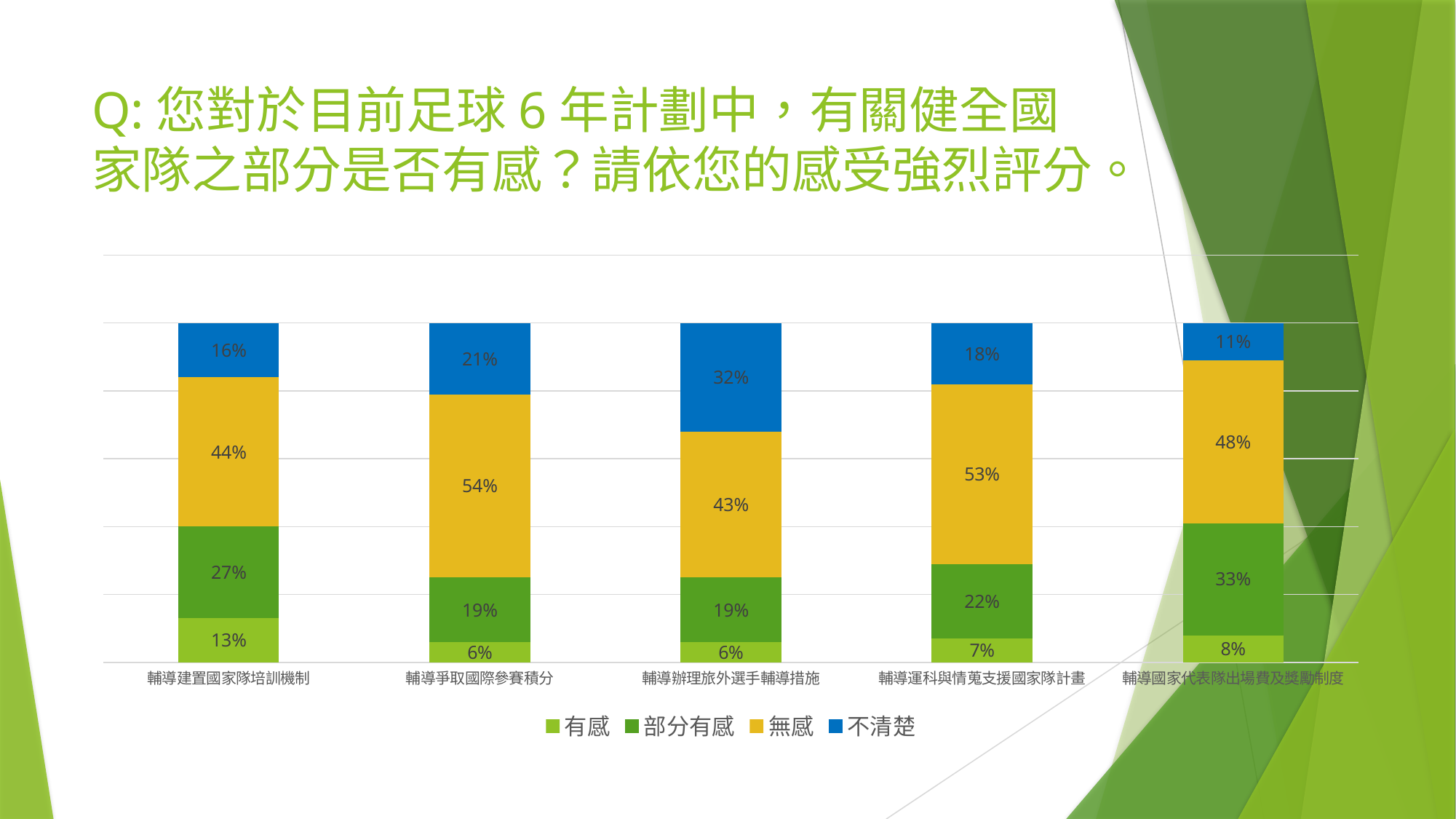
Which category has the lowest 有感 value? 輔導爭取國際參賽積分 and 輔導辦理旅外選手輔導措施 (both 6%) What is the 有感 value for 輔導建置國家隊培訓機制? 13% What is the difference between the 無感 values for 輔導運科與情蒐支援國家隊計畫 and 輔導建置國家隊培訓機制? 9% Which is larger: the 部分有感 value for 輔導建置國家隊培訓機制 or for 輔導運科與情蒐支援國家隊計畫? 輔導建置國家隊培訓機制 What is the 無感 value for 輔導爭取國際參賽積分? 54% What type of chart is shown on the slide? stacked bar chart How many series does the legend list? 4 How many categories are shown on the x axis of the chart? 5 What is the total of the stacked bar for 輔導國家代表隊出場費及獎勵制度? 100% Which category has the highest 不清楚 value? 輔導辦理旅外選手輔導措施 What is the 不清楚 value for 輔導辦理旅外選手輔導措施? 32% What is the 部分有感 value for 輔導國家代表隊出場費及獎勵制度? 33%